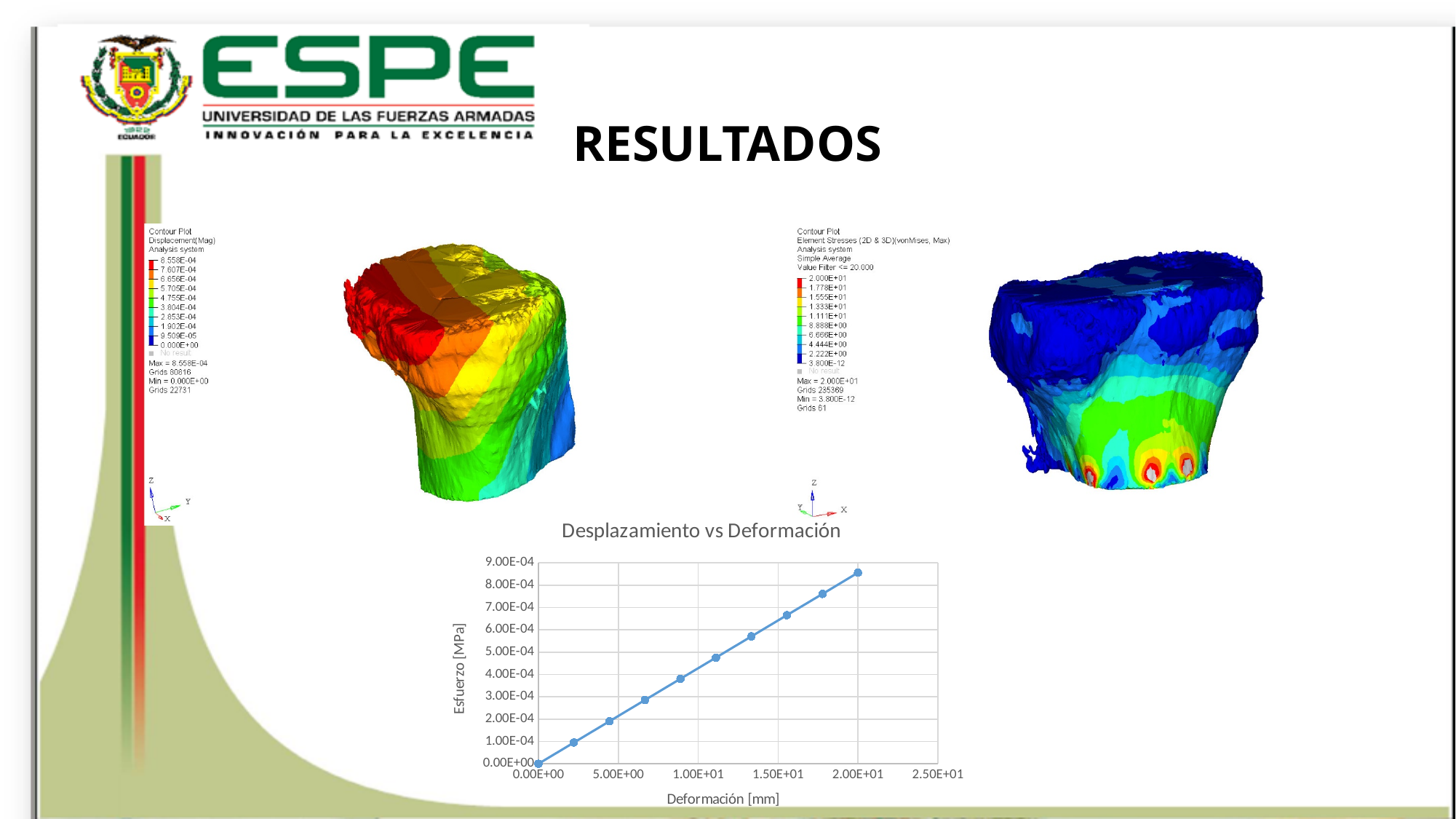
What is the label of the y axis in the "Desplazamiento vs Deformación" chart? Esfuerzo [MPa] What kind of chart is "Desplazamiento vs Deformación"? line chart What is the title of the chart at the bottom of the slide? Desplazamiento vs Deformación In the "Desplazamiento vs Deformación" chart, is the Esfuerzo value of the last point (at Deformación 2.00E+01) greater or less than 8.00E-04? greater In the "Desplazamiento vs Deformación" chart, which point has the highest Esfuerzo value: the one at Deformación 0.00E+00 or the one at Deformación 2.00E+01? the one at 2.00E+01 How many data points are plotted in the "Desplazamiento vs Deformación" chart? 10 In the "Desplazamiento vs Deformación" chart, what is the Esfuerzo value of the first point, at Deformación 0.00E+00? 0.00E+00 In the "Desplazamiento vs Deformación" chart, do the values rise or fall as Deformación increases? rise